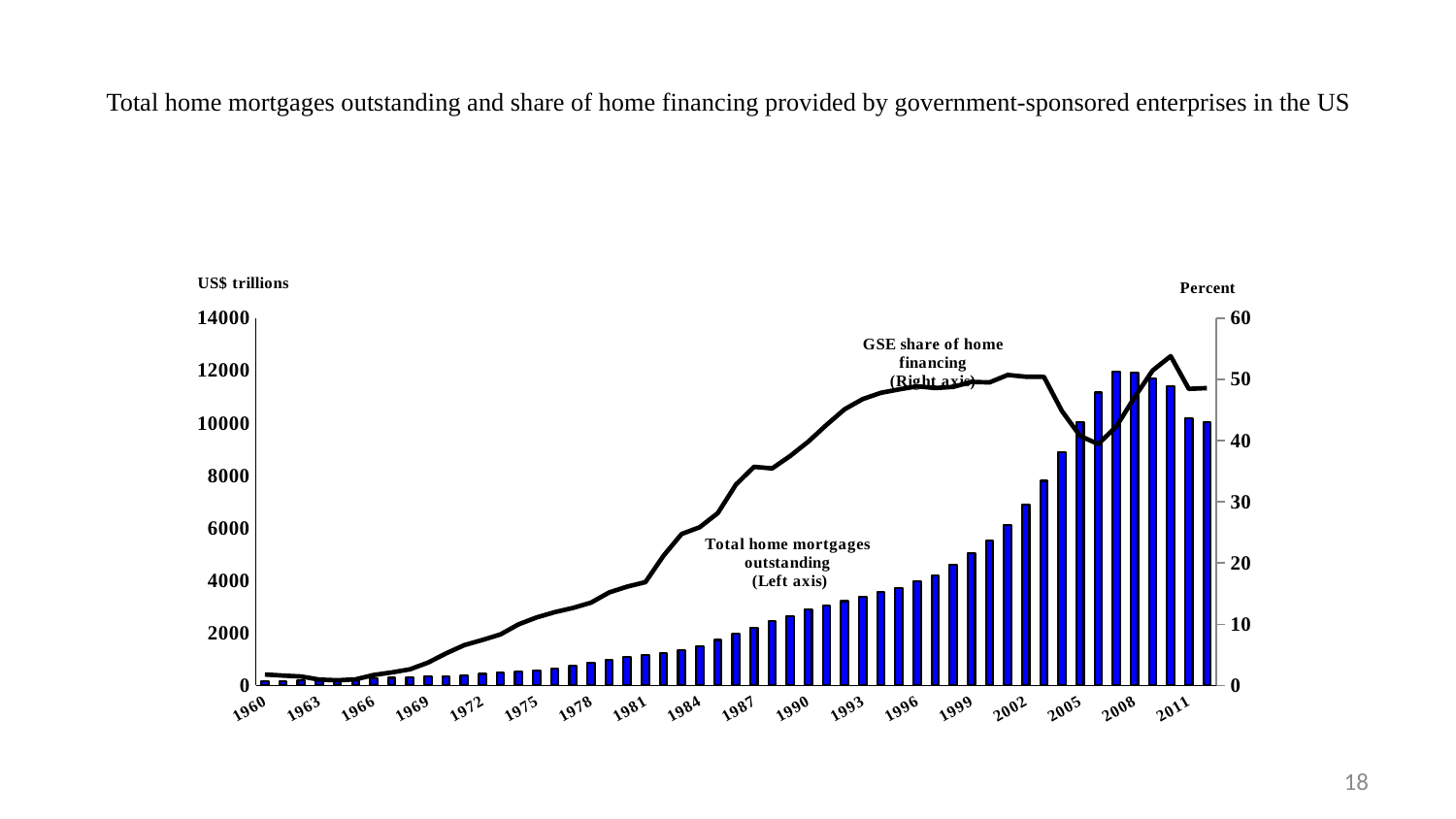
Which year has the lowest bar for total home mortgages outstanding? 1960 What kind of chart is shown on the slide? bar and line chart How many data series are plotted on the chart? 2 Is the value for total home mortgages outstanding in 2008 greater or less than 10000? greater What unit label is shown above the left axis? US$ trillions Is the value for total home mortgages outstanding in 1990 greater or less than 4000? less Which is larger, the total home mortgages outstanding bar for 2005 or for 1999? 2005 Is the value for total home mortgages outstanding in 1981 greater or less than 2000? less Does the GSE share of home financing line rise or fall between 2002 and 2005? fall Do the bars for total home mortgages outstanding generally rise or fall from 1960 to 2008? rise